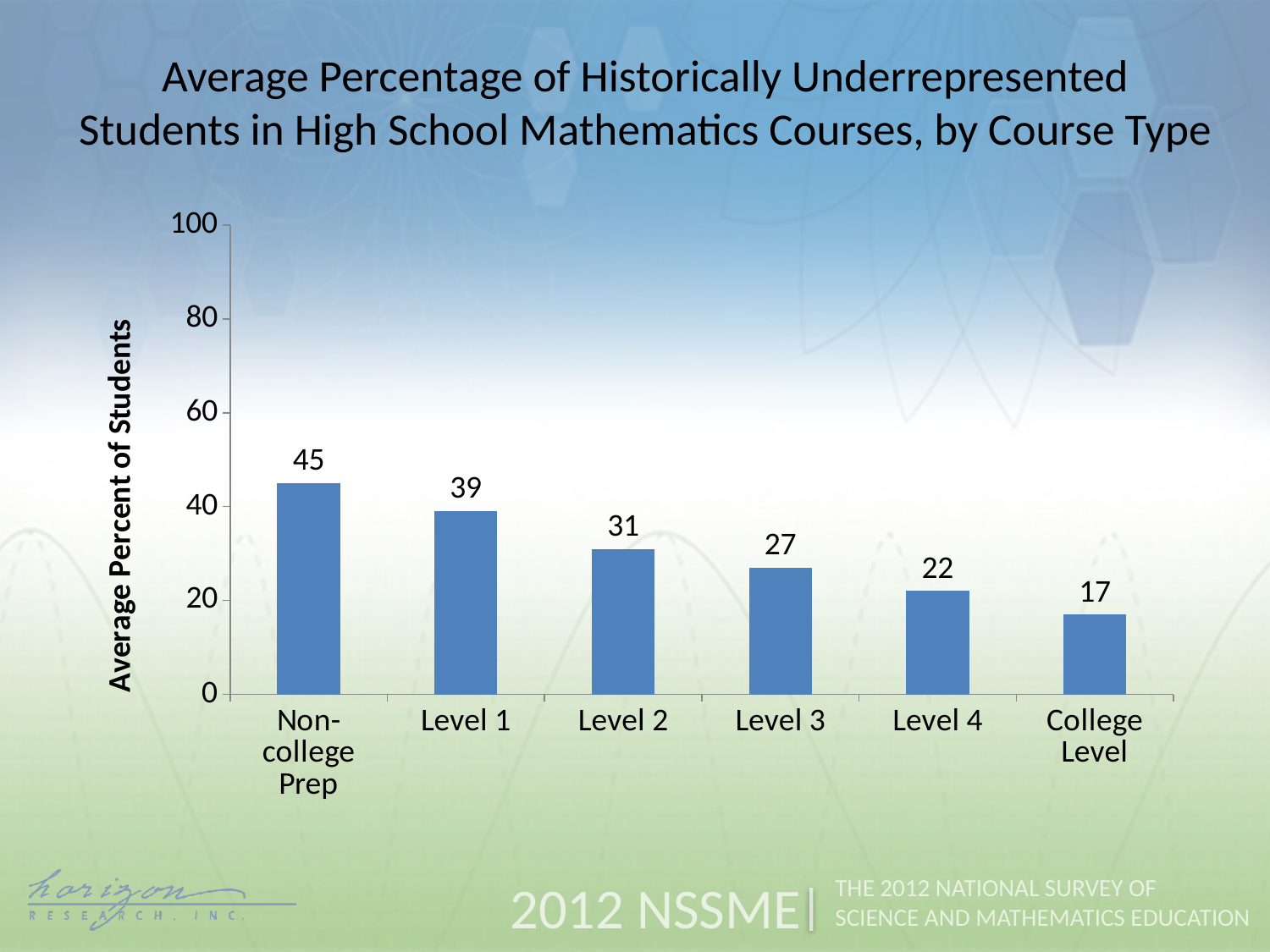
Which is larger, the value for Level 3 or the value for Level 4? Level 3 What kind of chart is shown on the slide? bar chart What is the value shown for College Level courses? 17 What is the value shown for Level 2 courses? 31 Is the value for Level 1 greater or less than 40? less How many course types are shown on the x axis? 6 Which course type has the lowest average percent of historically underrepresented students? College Level Do the values rise or fall moving from Non-college Prep to College Level along the x axis? fall What is the difference between the values for Non-college Prep and College Level? 28 What is the average percent of historically underrepresented students in Non-college Prep mathematics courses? 45 Which course type has the highest average percent of historically underrepresented students? Non-college Prep What is the difference between the values for Level 1 and Level 4? 17